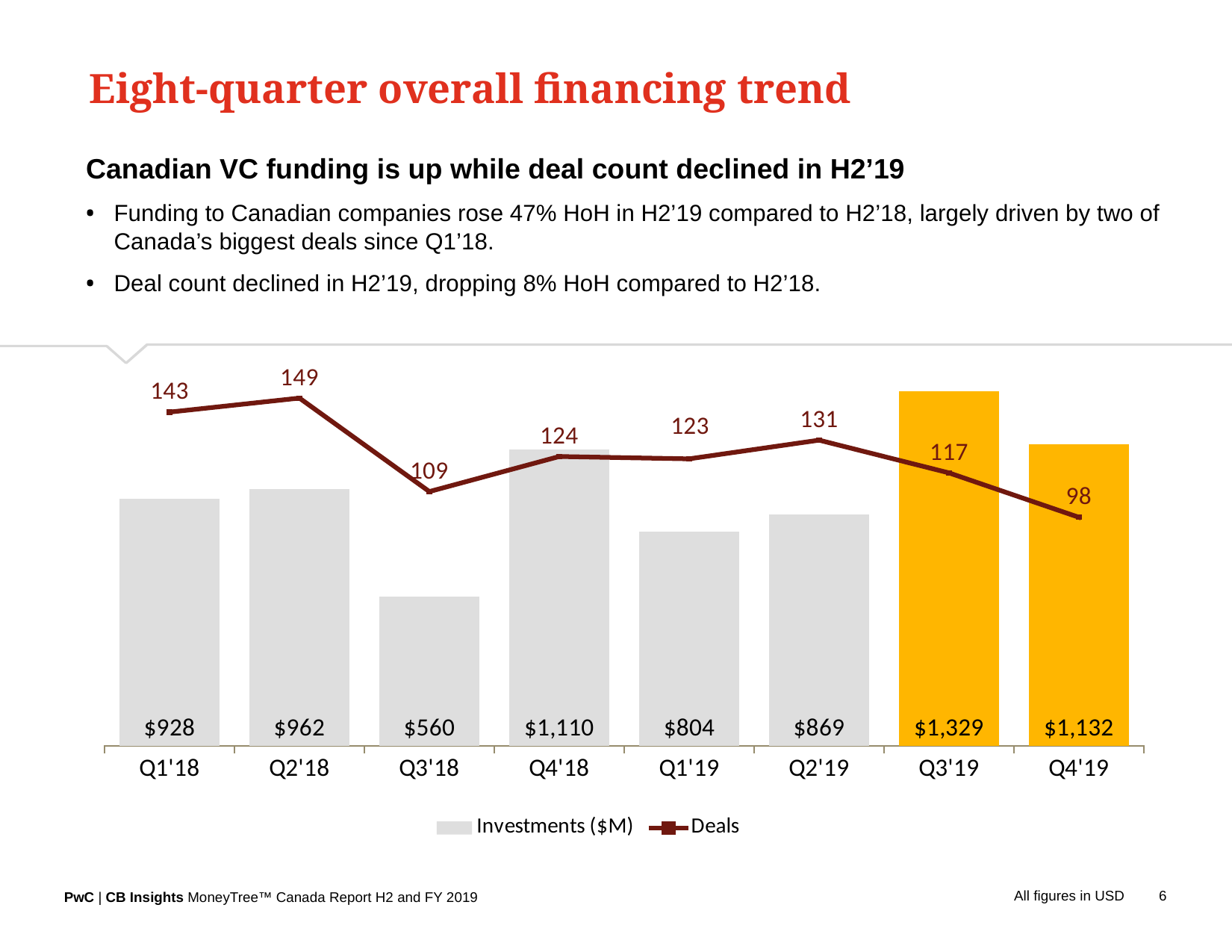
Which quarters' bars are highlighted in orange? Q3'19 and Q4'19 Which quarter has the lowest number of Deals? Q4'19 Which quarter had more Deals, Q4'18 or Q2'19? Q2'19 What is the difference in Investments ($M) between Q3'19 and Q4'19? $197 What is the difference in Deals between Q1'18 and Q4'19? 45 What is the Investments ($M) value for Q3'19? $1,329 How many Deals were there in Q2'18? 149 Which quarter has the highest number of Deals? Q2'18 Which quarter has the lowest Investments ($M) value? Q3'18 How many quarters are shown on the x axis? 8 What kind of chart is this? Combined bar and line chart How many series does the legend list? 2